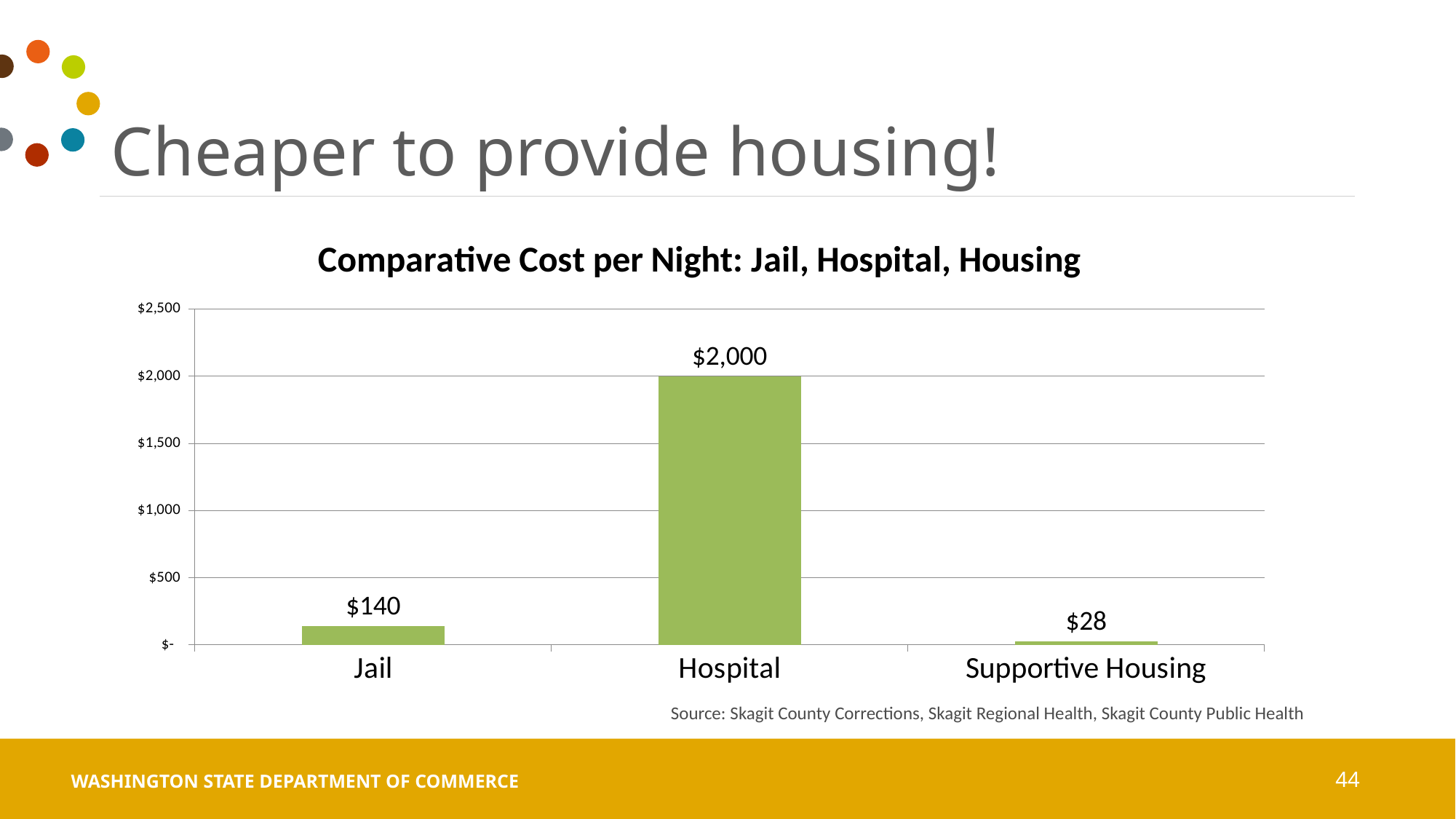
What is the difference in cost per night between Jail and Supportive Housing? $112 What is the cost per night for Supportive Housing? $28 Which has a higher cost per night, Jail or Supportive Housing? Jail What is the difference in cost per night between Hospital and Jail? $1,860 Which category has the highest cost per night? Hospital What is the cost per night for Jail? $140 What is the title of the chart? Comparative Cost per Night: Jail, Hospital, Housing What kind of chart is shown on the slide? Bar chart What is the cost per night for Hospital? $2,000 Is the value for Hospital greater or less than $1,500? greater How many categories are shown in the chart? 3 Which category has the lowest cost per night? Supportive Housing